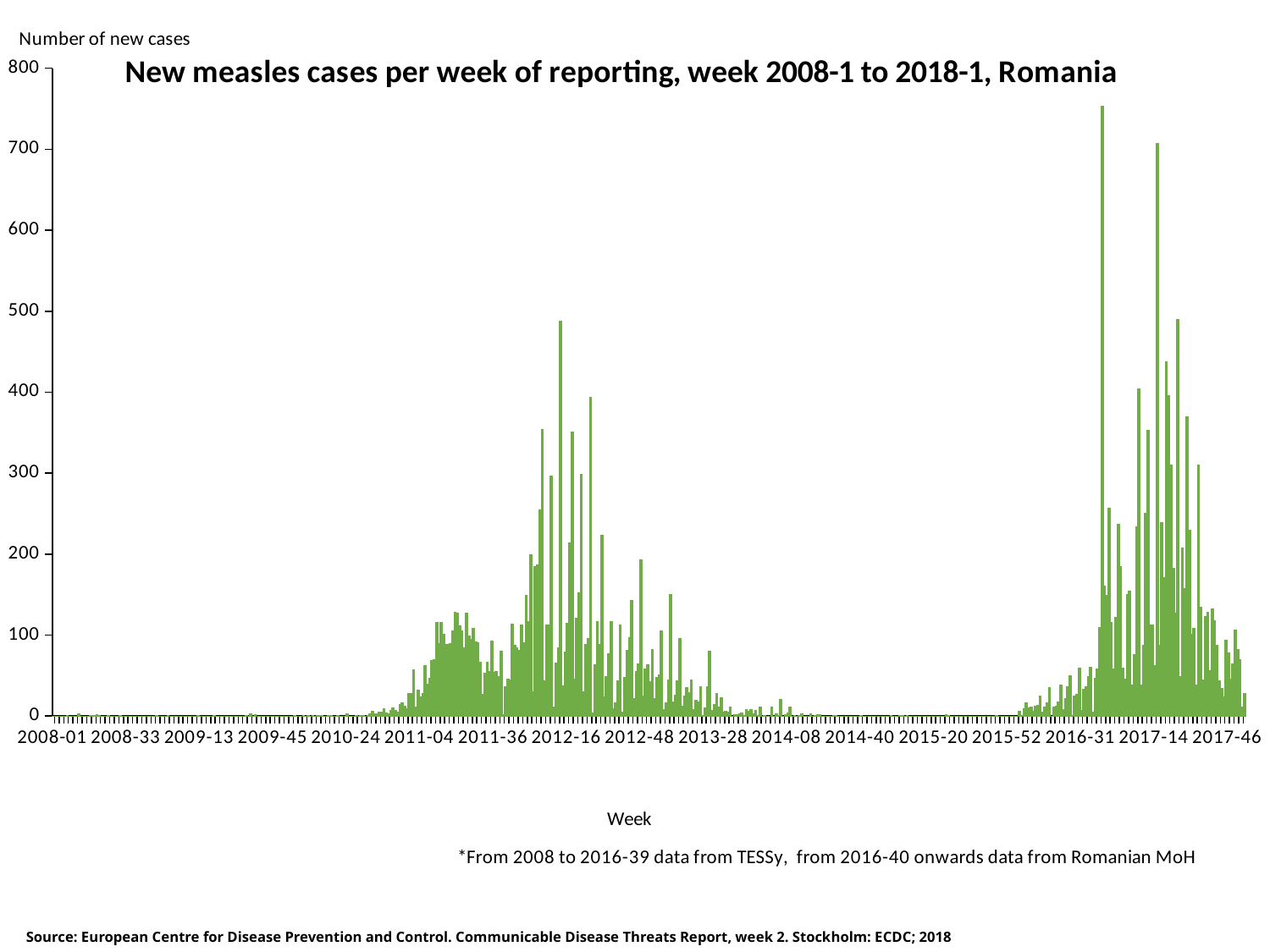
Is the highest bar of the outbreak around week 2012-16 greater or less than 400? greater Between week 2015-52 and week 2016-31, do the weekly case numbers generally rise or fall? rise Is the highest bar in the chart greater or less than 800? less Is the value for week 2015-20 greater or less than 100? less What kind of chart is shown on the slide? Bar chart Between week 2013-28 and week 2015-20, do the weekly case numbers generally rise or fall? fall Which outbreak reached a higher weekly peak, the one around 2012-16 or the one around 2017-14? The one around 2017-14 What label is given to the vertical axis of the chart? Number of new cases What is the title of the chart? New measles cases per week of reporting, week 2008-1 to 2018-1, Romania